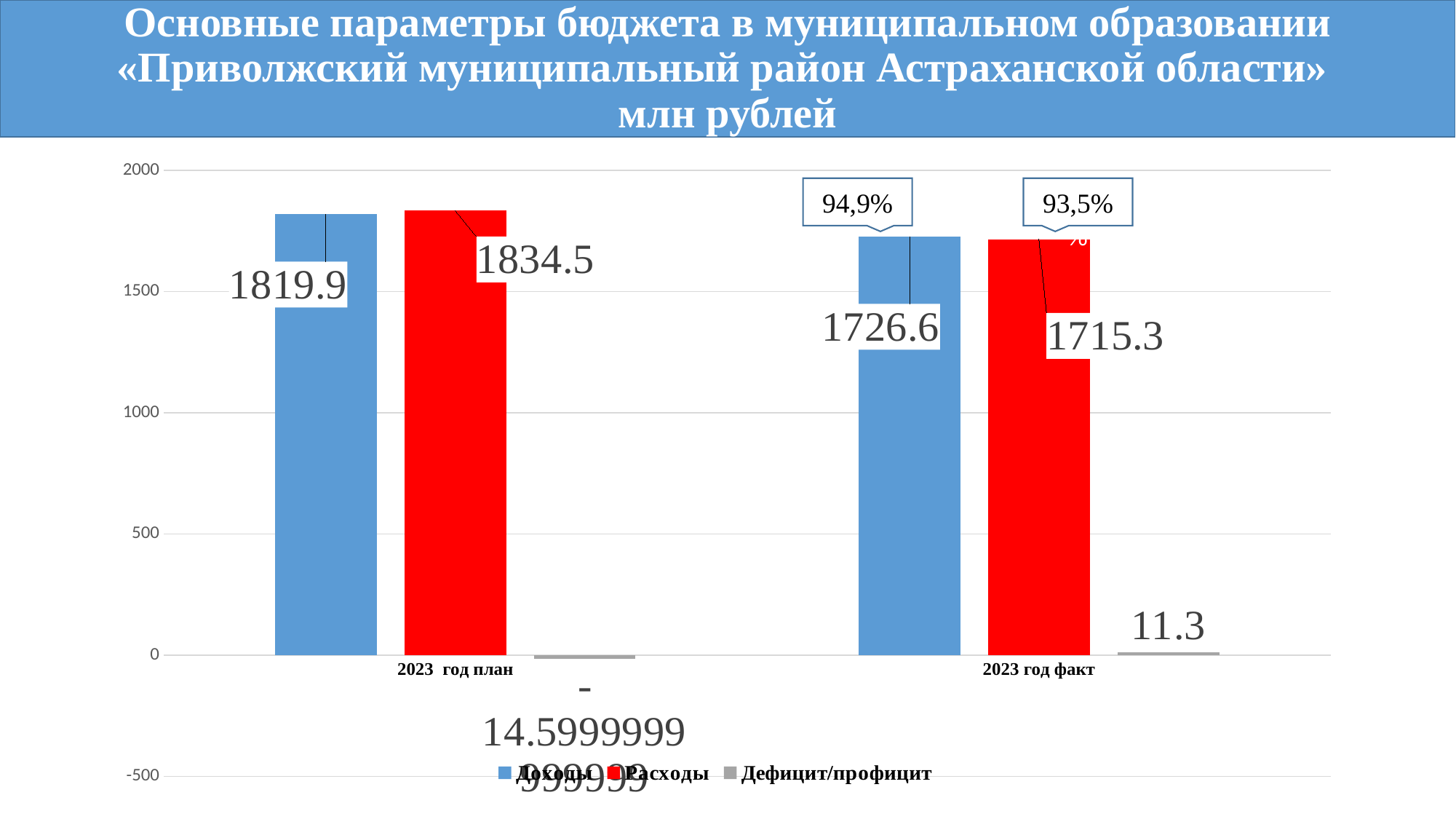
What is the value of Доходы for 2023 год план? 1819.9 What percentage is shown in the callout above the Доходы bar for 2023 год факт? 94,9% What is the difference between Доходы for 2023 год план and Доходы for 2023 год факт? 93.3 What kind of chart is shown on the slide? Bar chart What is the difference between Расходы and Доходы for 2023 год план? 14.6 What is the value of Расходы for 2023 год план? 1834.5 What is the value of Расходы for 2023 год факт? 1715.3 How many series does the legend list? 3 Which is larger for 2023 год план: Доходы or Расходы? Расходы What is the value of Дефицит/профицит for 2023 год факт? 11.3 Is the value of Доходы for 2023 год факт greater or less than 1500? greater What is the value of Доходы for 2023 год факт? 1726.6